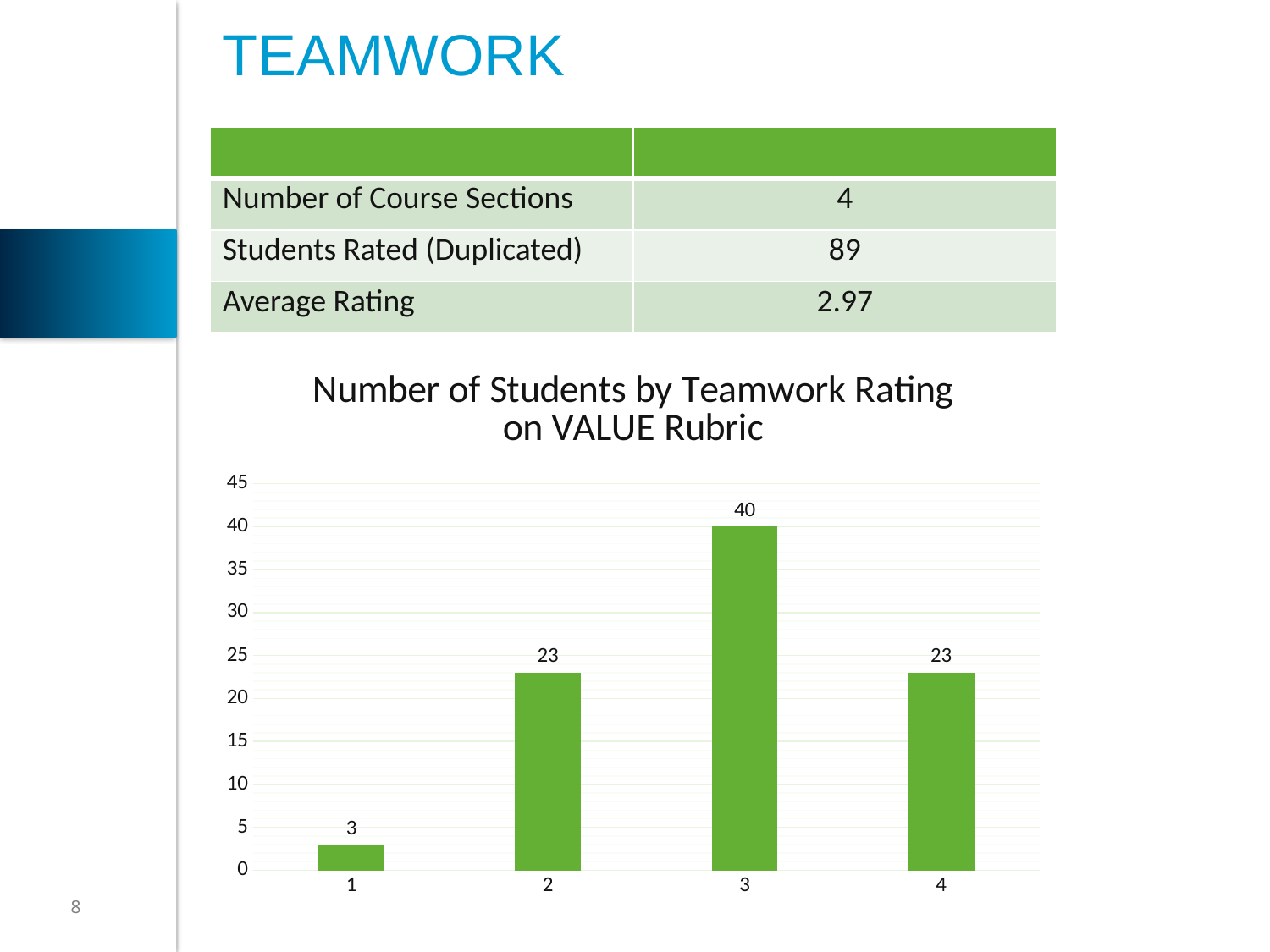
What is the number of students with a teamwork rating of 1? 3 What is the number of students with a teamwork rating of 2? 23 What is the difference between the number of students rated 3 and the number rated 4? 17 What is the difference between the number of students rated 2 and the number rated 1? 20 What is the number of students with a teamwork rating of 3? 40 Which has more students, rating 1 or rating 2? Rating 2 Which teamwork rating has the lowest number of students? 1 Is the number of students with rating 3 greater or less than 35? greater How many rating categories are shown on the x axis of the chart? 4 What is the title of the chart? Number of Students by Teamwork Rating on VALUE Rubric Which teamwork rating has the highest number of students? 3 What kind of chart is shown on the slide? Bar chart